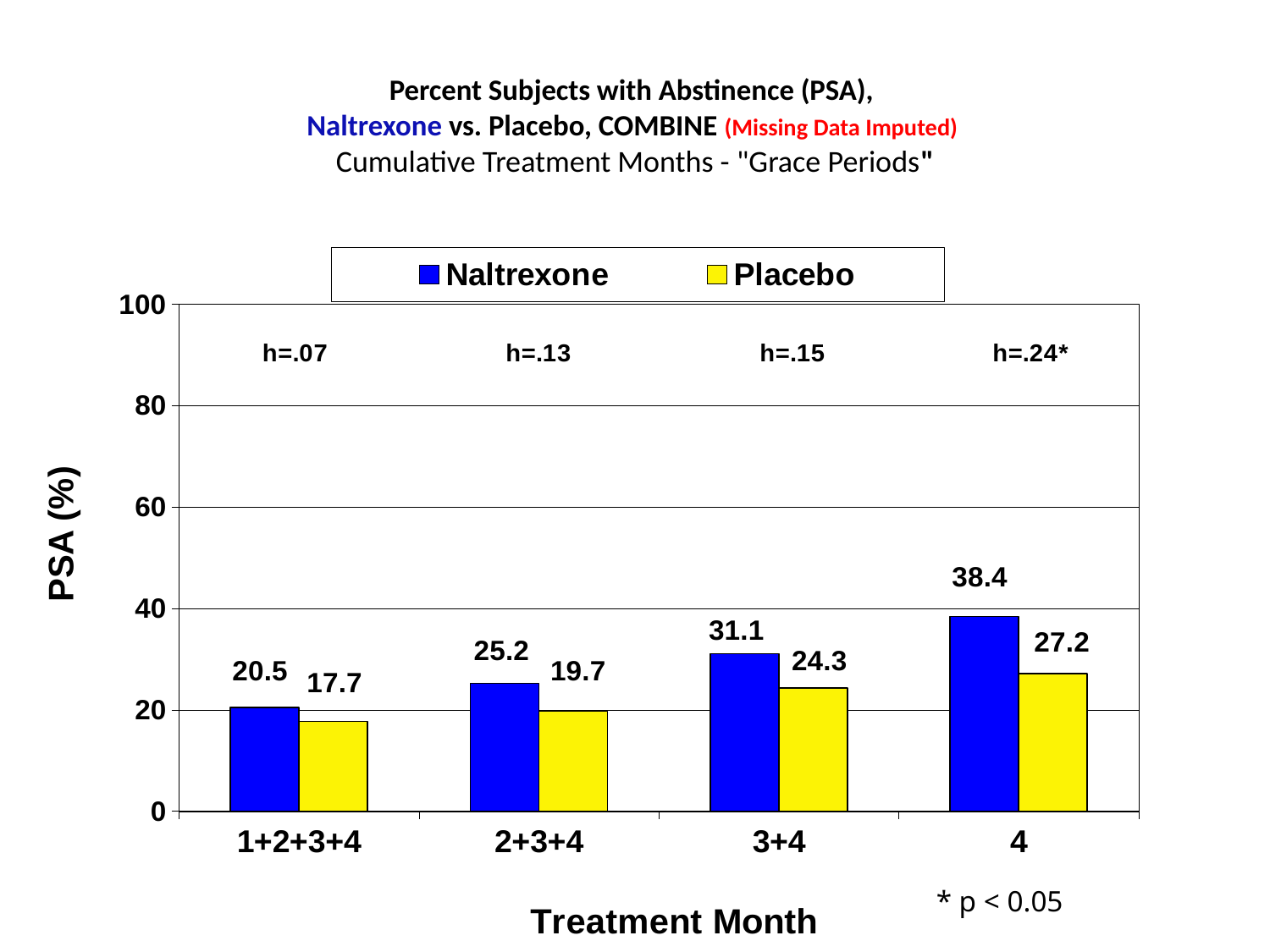
Which treatment month category has the lowest Placebo value? 1+2+3+4 What is the difference between the Naltrexone and Placebo values for treatment month 2+3+4? 5.5 How many series does the legend list? 2 What kind of chart is shown on the slide? bar chart What is the Naltrexone value for treatment month 4? 38.4 Which treatment month category has the highest Naltrexone value? 4 Do the Naltrexone values rise or fall from left to right along the x axis? rise How many treatment month categories are shown on the x axis? 4 Which is larger for treatment month 3+4, the Naltrexone value or the Placebo value? Naltrexone What is the Placebo value for treatment month 1+2+3+4? 17.7 What is the difference between the Naltrexone and Placebo values for treatment month 4? 11.2 What is the Placebo value for treatment month 3+4? 24.3